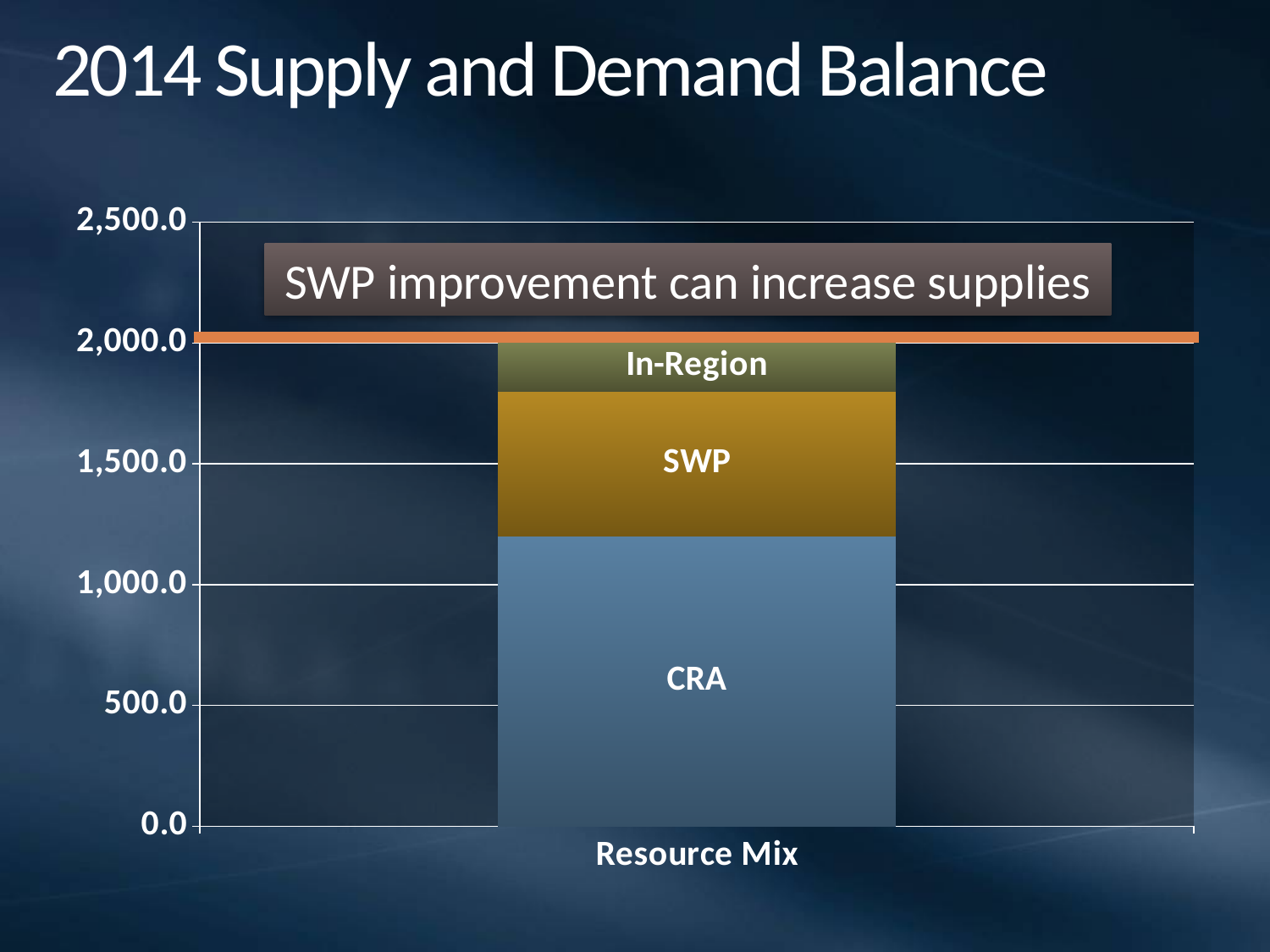
What is the label of the single category on the x axis? Resource Mix Which segment of the Resource Mix bar is the smallest? In-Region Is the value of the In-Region segment greater or less than 500.0? less Which segment of the Resource Mix bar is the largest? CRA How many categories are shown on the x axis of the chart? 1 Is the value of the CRA segment greater or less than 1,000.0? greater Which is larger in the Resource Mix bar, the SWP segment or the In-Region segment? SWP How many segments make up the stacked bar for Resource Mix? 3 What kind of chart is shown on the slide? stacked bar chart Is the total height of the Resource Mix stacked bar greater or less than 1,500.0? greater Which is larger in the Resource Mix bar, the CRA segment or the SWP segment? CRA What is the title of the slide containing the chart? 2014 Supply and Demand Balance